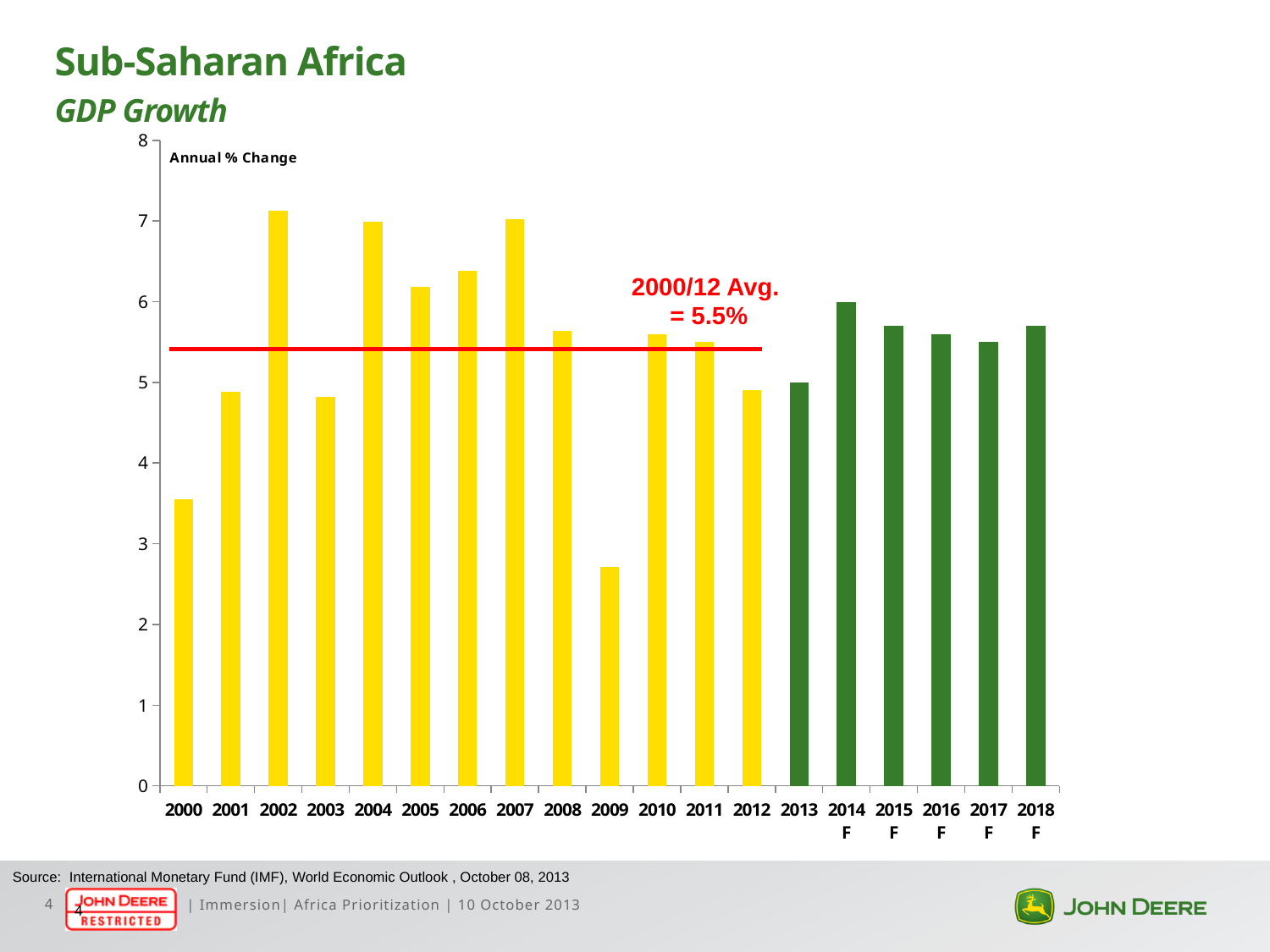
Is the value for 2014 F greater or less than 5? greater How many years (bars) are plotted in the chart? 19 Is the value for 2005 greater or less than 6? greater What unit label is shown at the top of the chart's y axis? Annual % Change What is the 2000/12 average GDP growth shown by the red line? 5.5% Is the value for 2000 greater or less than 4? less Do the forecast values rise or fall from 2014 F to 2017 F? fall Which year has the larger value, 2000 or 2009? 2000 What kind of chart is shown on the slide? bar chart Which year has the larger value, 2002 or 2003? 2002 Which year has the lowest GDP growth value in the chart? 2009